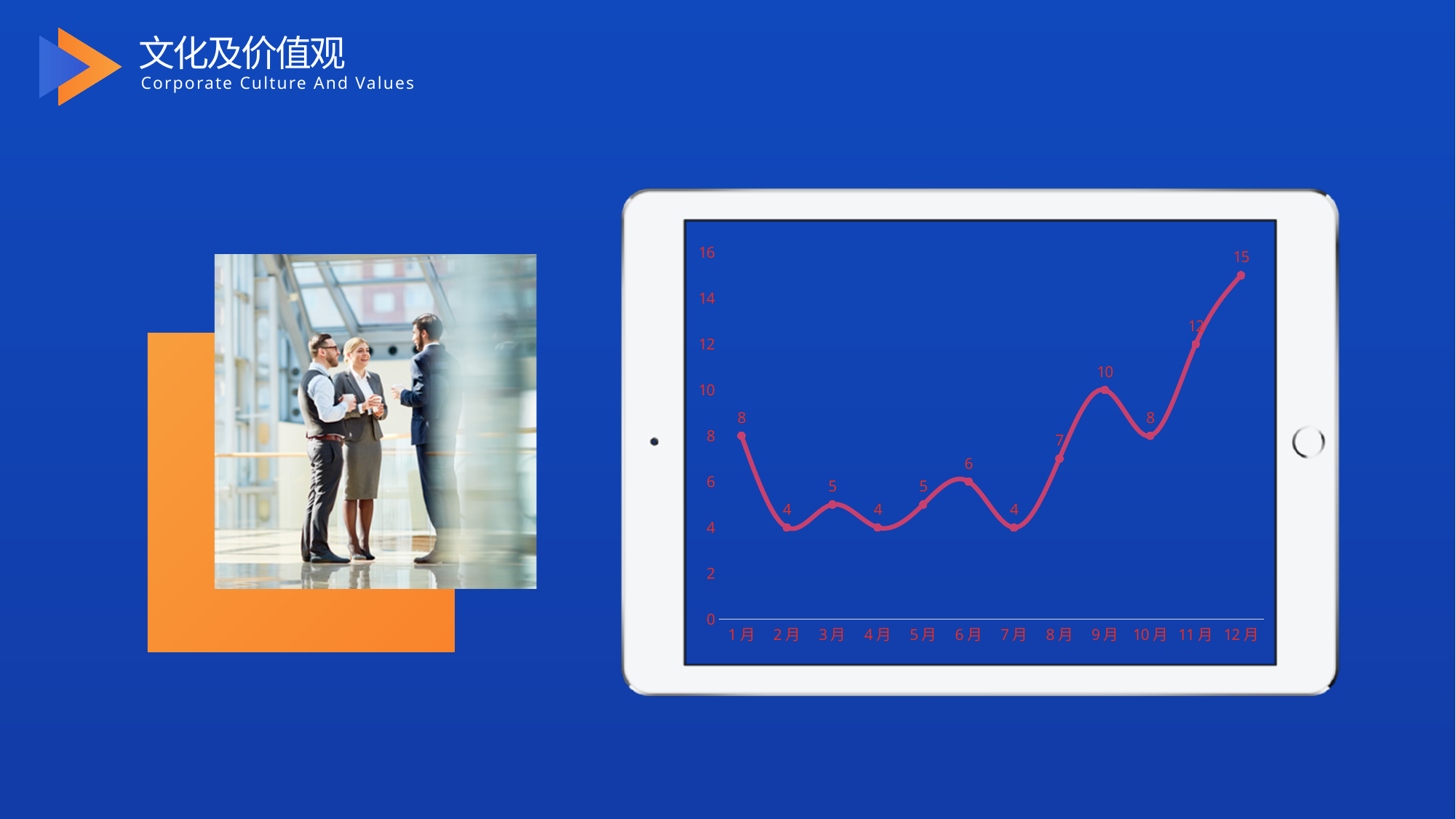
What is the value for 1月? 8 What type of chart is shown on the slide? line chart What is the difference between the values for 9月 and 10月? 2 What is the value for 6月? 6 What is the value for 9月? 10 What is the highest value shown on the y axis? 16 How many months are plotted on the x axis? 12 What is the difference between the values for 12月 and 11月? 3 Do the values generally rise or fall from 7月 to 12月? rise What is the value for 12月? 15 Which is larger, the value for 1月 or the value for 8月? 1月 Which month has the highest value? 12月